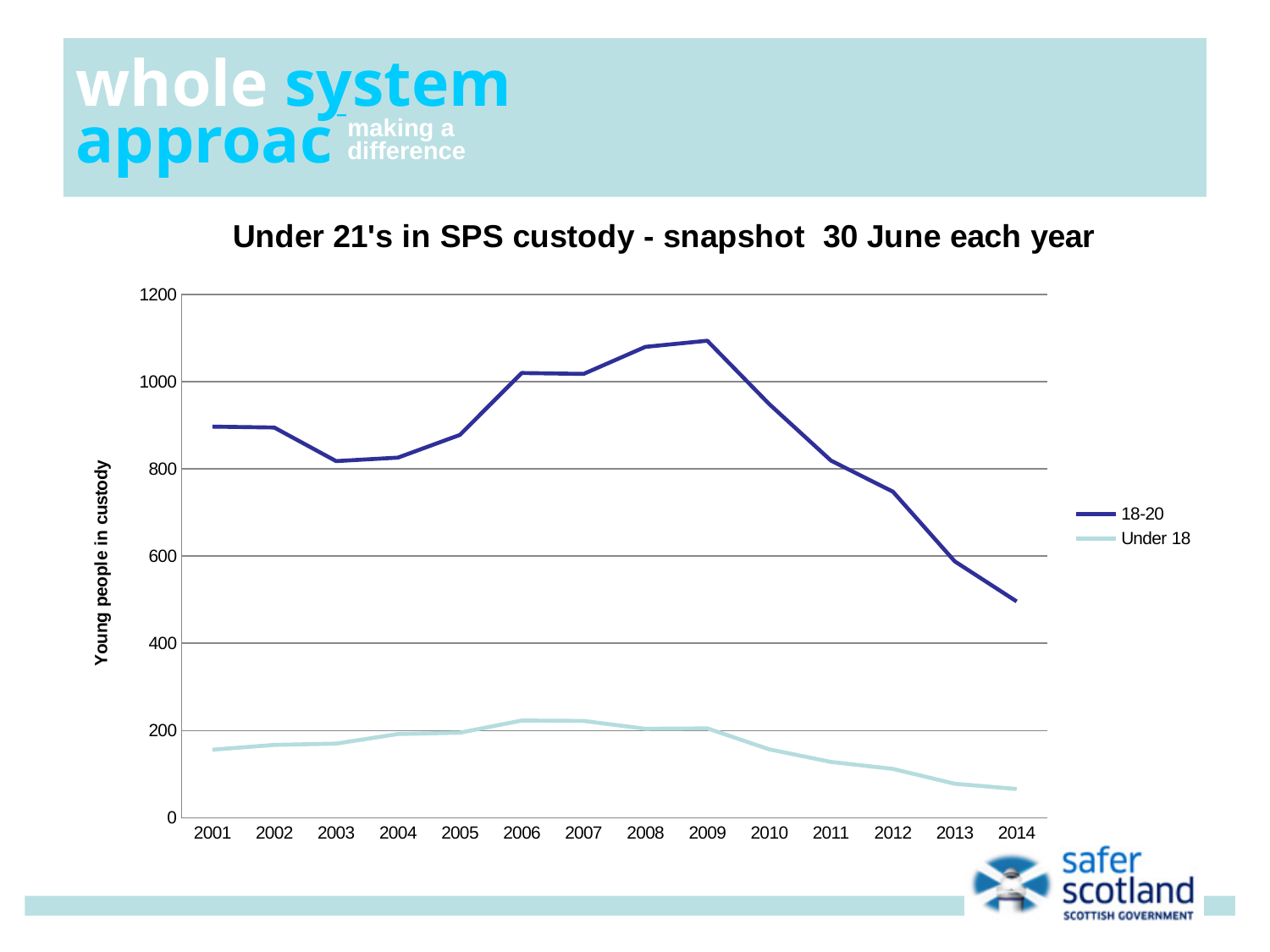
Is the value for the 18-20 series in 2009 greater or less than 1000? greater What is the label on the y axis? Young people in custody How many years are plotted along the x axis? 14 In which year does the 18-20 series reach its highest value? 2009 In which year does the Under 18 series reach its lowest value? 2014 Is the value for the 18-20 series in 2014 greater or less than 600? less In which year does the 18-20 series reach its lowest value? 2014 Which series has the larger value in 2009, 18-20 or Under 18? 18-20 Does the 18-20 series rise or fall between 2009 and 2014? Fall Is the value for the Under 18 series in 2014 greater or less than 100? less How many series does the legend list? 2 What kind of chart is shown on the slide? Line chart